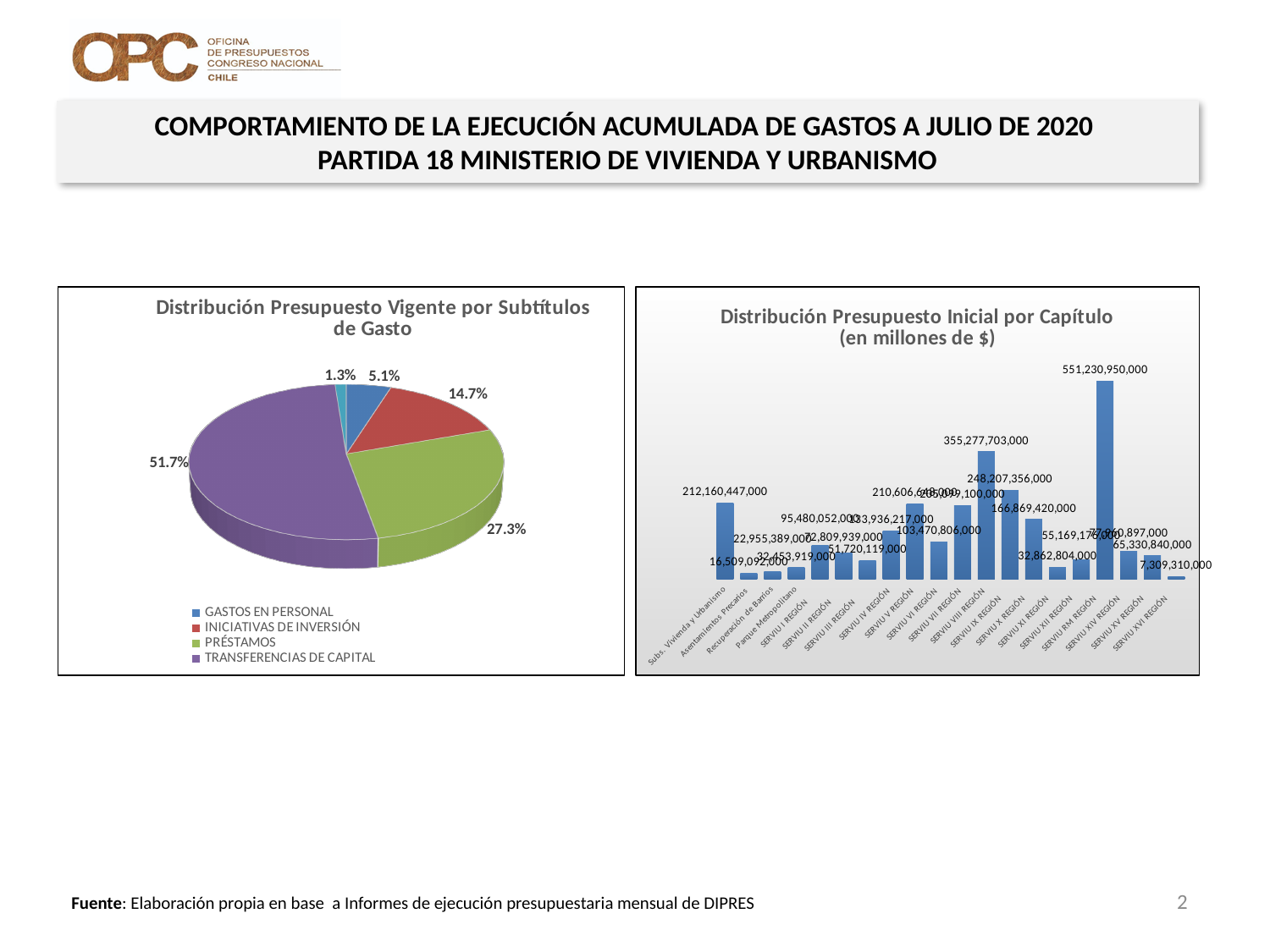
In the right bar chart, what is the value for SERVIU RM REGIÓN? 551,230,950,000 In the right bar chart, what is the value for Subs. Vivienda y Urbanismo? 212,160,447,000 What kind of chart is the 'Distribución Presupuesto Inicial por Capítulo' chart on the right? Bar chart In the left pie chart, which category has the largest share? TRANSFERENCIAS DE CAPITAL In the left pie chart, how many percentage points larger is TRANSFERENCIAS DE CAPITAL than PRÉSTAMOS? 24.4 percentage points In the left pie chart, what share does PRÉSTAMOS have? 27.3% In the right bar chart, which capítulo has the highest value? SERVIU RM REGIÓN In the left pie chart, what share does GASTOS EN PERSONAL have? 5.1% How many entries does the legend of the left pie chart list? 4 In the left pie chart, what share does TRANSFERENCIAS DE CAPITAL have? 51.7% In the left pie chart, which is larger: INICIATIVAS DE INVERSIÓN or GASTOS EN PERSONAL? INICIATIVAS DE INVERSIÓN What kind of chart is the 'Distribución Presupuesto Vigente por Subtítulos de Gasto' chart on the left? Pie chart